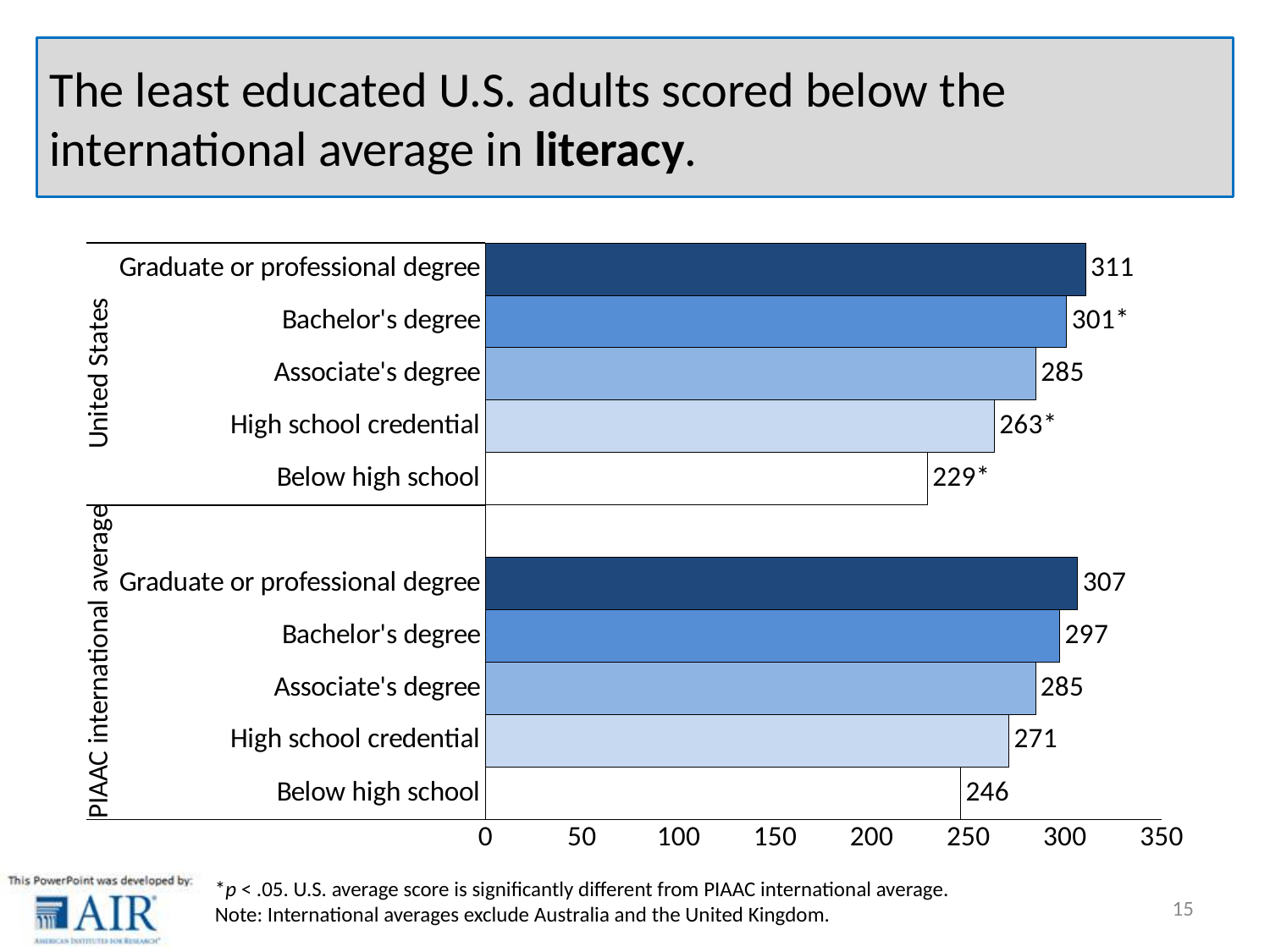
What type of chart is shown on the slide? Bar chart What is the difference between the PIAAC international average and the U.S. score for adults below high school? 17 What is the literacy score for U.S. adults with a graduate or professional degree? 311 What value is printed for U.S. adults with a bachelor's degree? 301* How many bars are plotted on the chart? 10 What is the difference between the U.S. and PIAAC international average scores for adults with a graduate or professional degree? 4 Which is larger: the U.S. score for adults with a high school credential or the PIAAC international average for adults with a high school credential? PIAAC international average Which bar has the highest value on the chart? United States, Graduate or professional degree Is the U.S. score for adults with an associate's degree greater or less than 250? greater Which bar has the lowest value on the chart? United States, Below high school What is the PIAAC international average literacy score for adults with a high school credential? 271 What is the PIAAC international average literacy score for adults below high school? 246